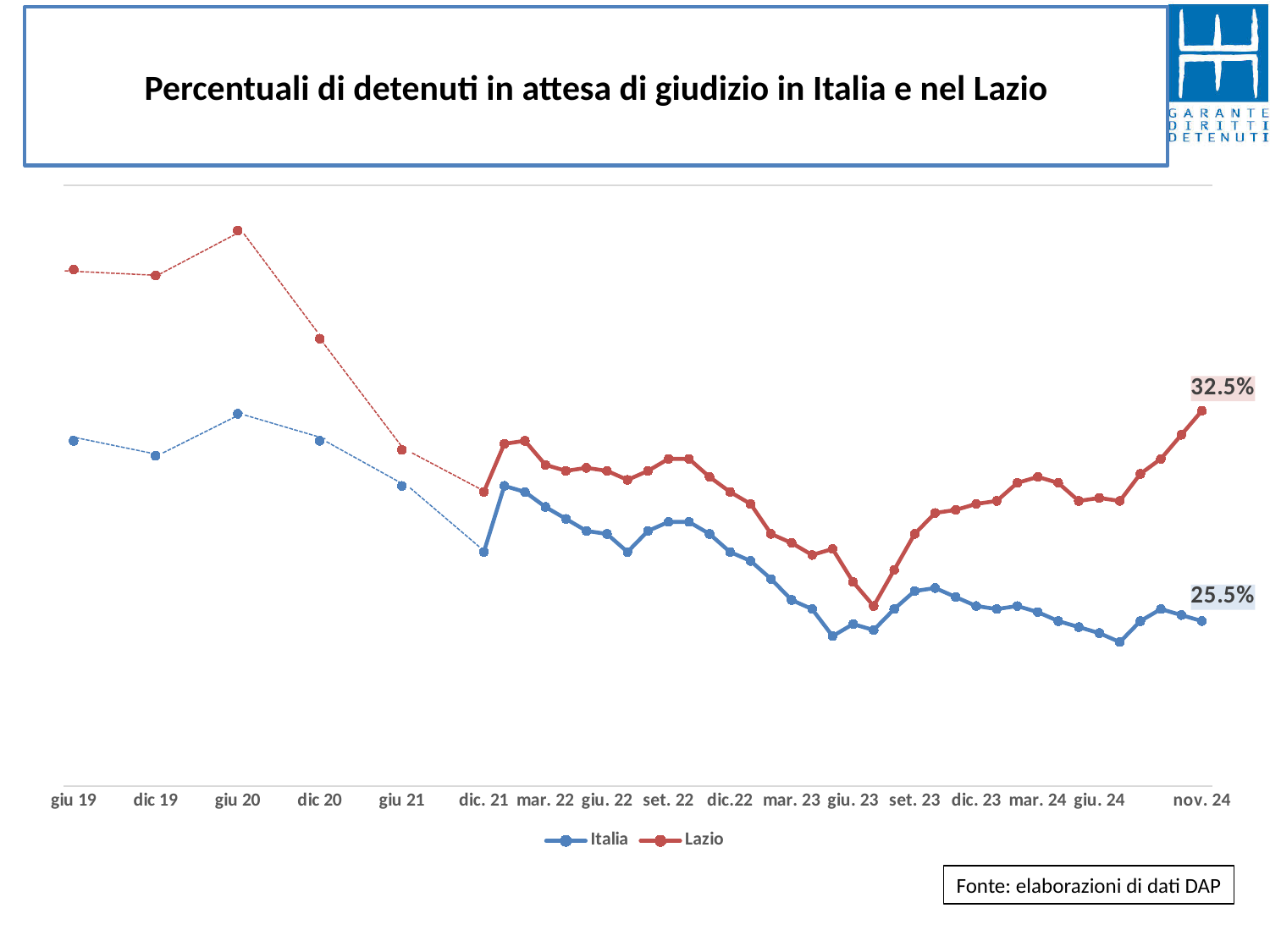
At nov. 24, which series has the higher value, Italia or Lazio? Lazio At which x-axis label does the Lazio series reach its highest point? giu 20 What is the title of the chart? Percentuali di detenuti in attesa di giudizio in Italia e nel Lazio What kind of chart is shown on the slide? Line chart What is the difference between the Lazio and Italia values at nov. 24? 7 percentage points How many series does the legend list? 2 Does the Lazio series rise or fall between giu. 23 and nov. 24? Rise What is the value for Lazio at nov. 24? 32.5% What colour is the Italia line in the chart? Blue What is the value for Italia at nov. 24? 25.5% Does the Lazio series rise or fall between giu 20 and giu. 23? Fall